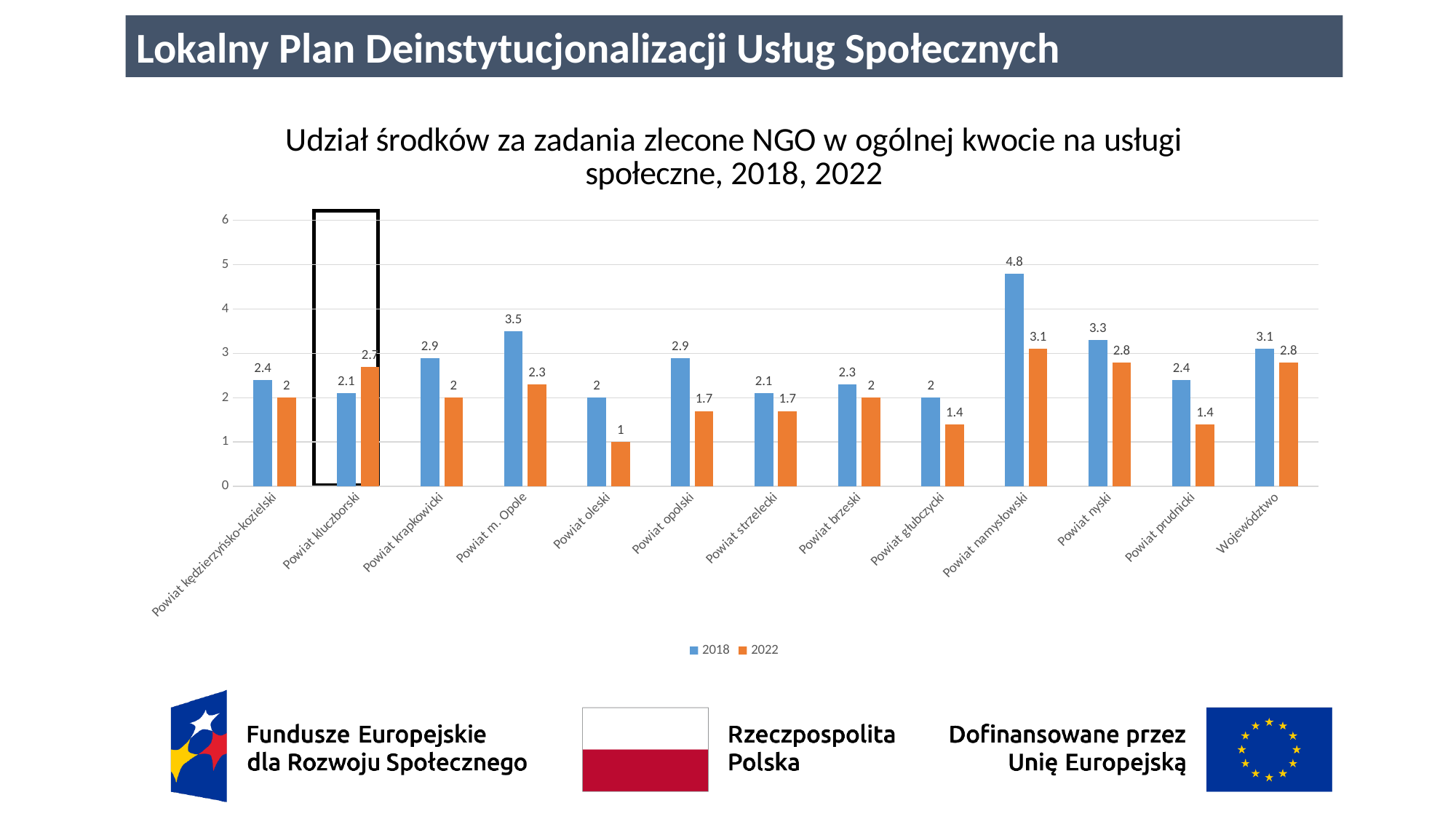
What kind of chart is shown on the slide? Bar chart Which category has the lowest 2022 value? Powiat oleski What is the 2022 value for Województwo? 2.8 What is the difference between the 2018 and 2022 values for Powiat m. Opole? 1.2 What is the 2022 value for Powiat kluczborski? 2.7 How many series does the legend list? 2 How many categories are shown on the x axis? 13 What is the 2018 value for Powiat namysłowski? 4.8 What is the 2022 value for Powiat oleski? 1 Which is larger for Powiat kluczborski, the 2018 value or the 2022 value? 2022 Which category has the highest 2018 value? Powiat namysłowski Is the 2018 value for Powiat nyski greater or less than 3? greater